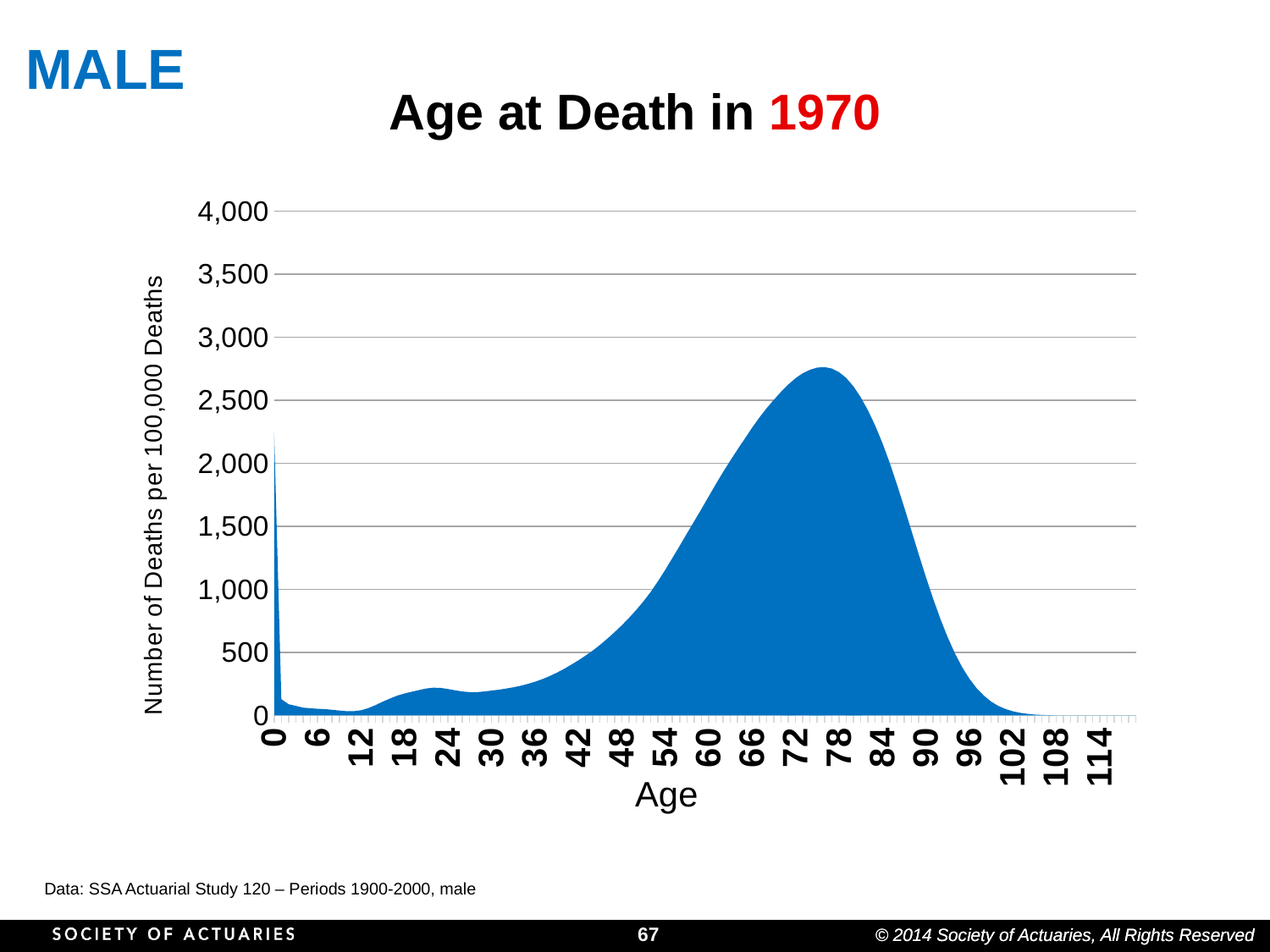
What kind of chart is shown on the slide? Area chart Is the value at age 48 greater or less than 500? greater Is the value at age 0 greater or less than 1,500? greater What is the label of the y-axis? Number of Deaths per 100,000 Deaths Is the value at age 36 greater or less than 500? less Which is larger, the value at age 78 or the value at age 96? Age 78 Do the values rise or fall between age 48 and age 72? Rise Which is larger, the value at age 72 or the value at age 24? Age 72 What is the title of the chart? Age at Death in 1970